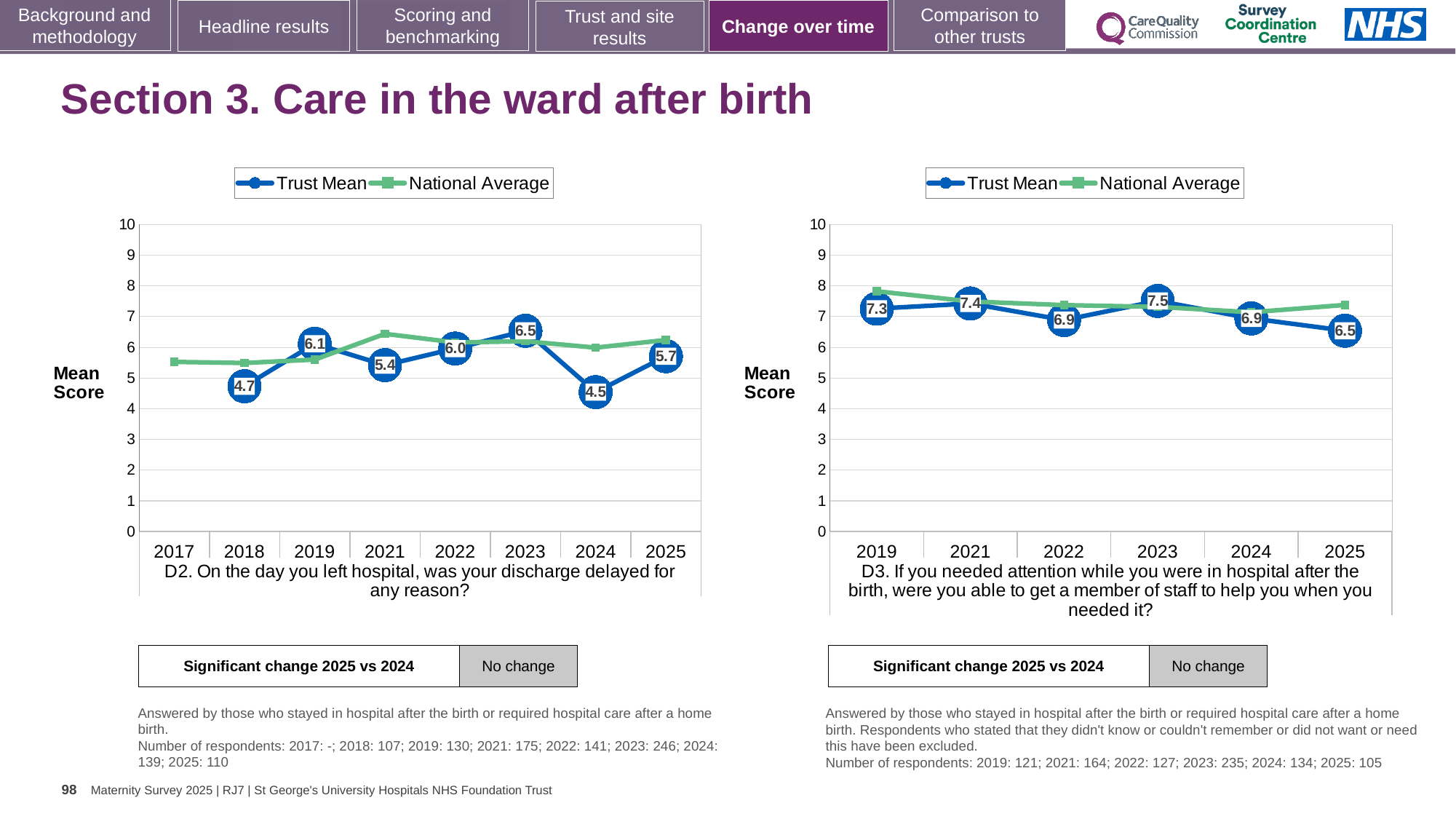
In the D3 chart (right), what is the difference between the Trust Mean for 2019 and the Trust Mean for 2025? 0.8 What kind of chart is the D3 chart (right)? Line chart In the D2 chart (left), what is the difference between the Trust Mean for 2023 and the Trust Mean for 2024? 2.0 In the D2 chart (left), which is larger: the Trust Mean for 2019 or the Trust Mean for 2021? 2019 In the D3 chart (right), what is the Trust Mean for 2025? 6.5 How many series does the legend of the D2 chart (left) list? 2 In the D2 chart (left), which year has the lowest Trust Mean? 2024 In the D3 chart (right), which year has the highest Trust Mean? 2023 How many years are shown on the x axis of the D3 chart (right)? 6 In the D2 chart (left), what is the Trust Mean for 2024? 4.5 In the D2 chart (left), what is the Trust Mean for 2023? 6.5 In the D2 chart (left), is the National Average for 2017 greater or less than 5? greater